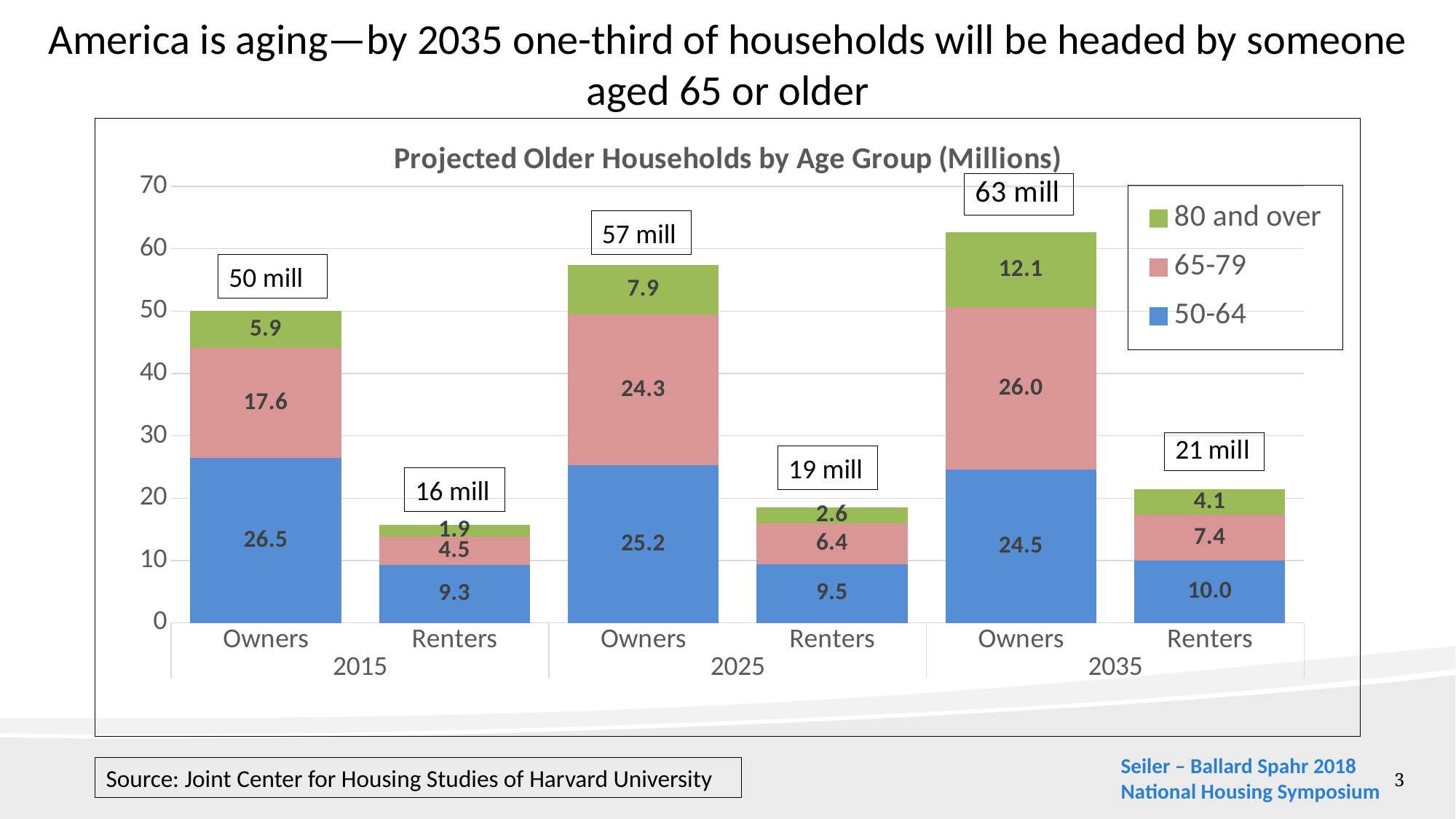
What kind of chart is shown on the slide? Stacked bar chart What total is labelled above the Renters bar for 2025? 19 mill What is the difference between the 80 and over values for Owners in 2035 and Owners in 2015? 6.2 What is the value for the 80 and over age group for Owners in 2025? 7.9 Do the labelled totals for Owners rise or fall from 2015 to 2035? Rise What is the value for the 50-64 age group for Renters in 2015? 9.3 How many bars are plotted in the chart? 6 Which is larger: the 65-79 value for Owners in 2025 or the 50-64 value for Owners in 2025? 50-64 (25.2) What is the value for the 65-79 age group for Owners in 2035? 26.0 Which bar has the lowest total, as labelled on the chart? Renters 2015 (16 mill) Which bar has the highest total, as labelled on the chart? Owners 2035 (63 mill) How many series does the legend list? 3